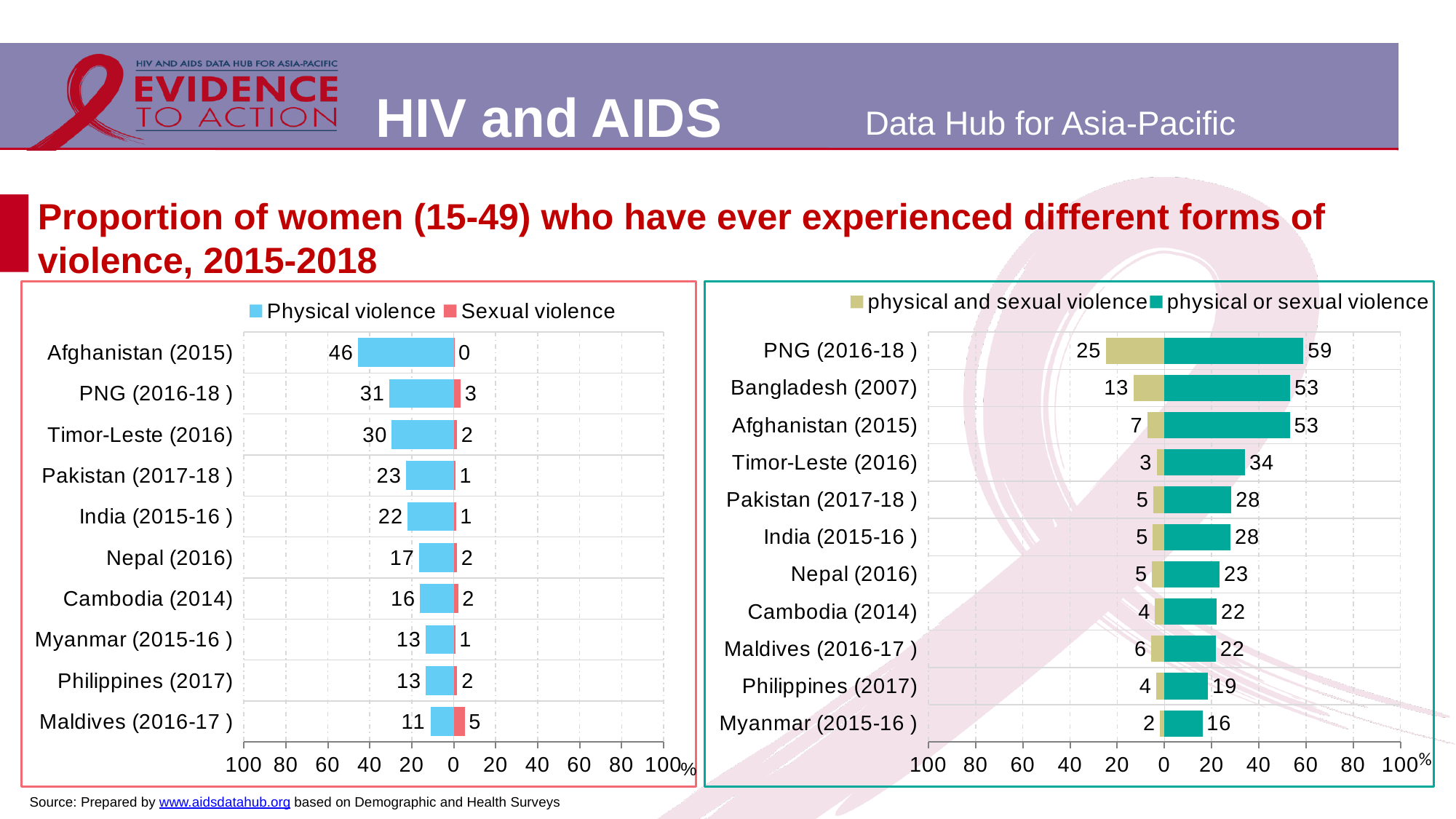
In the left chart (Physical violence / Sexual violence), what is the physical violence value for Afghanistan (2015)? 46 In the left chart (Physical violence / Sexual violence), how many series does the legend list? 2 In the right chart (physical and sexual violence / physical or sexual violence), how many countries are shown? 11 What kind of chart is the left chart (Physical violence / Sexual violence)? Bar chart In the left chart (Physical violence / Sexual violence), which country has the highest physical violence value? Afghanistan (2015) In the right chart (physical and sexual violence / physical or sexual violence), what is the physical and sexual violence value for Bangladesh (2007)? 13 In the right chart (physical and sexual violence / physical or sexual violence), which country has the lowest physical or sexual violence value? Myanmar (2015-16) In the right chart (physical and sexual violence / physical or sexual violence), what is the physical or sexual violence value for PNG (2016-18)? 59 In the left chart (Physical violence / Sexual violence), which country has the lowest physical violence value? Maldives (2016-17) In the left chart (Physical violence / Sexual violence), what is the difference between the physical violence values for PNG (2016-18) and Timor-Leste (2016)? 1 In the right chart (physical and sexual violence / physical or sexual violence), which is larger: the physical or sexual violence value for Timor-Leste (2016) or for Pakistan (2017-18)? Timor-Leste (2016) In the left chart (Physical violence / Sexual violence), what is the sexual violence value for Maldives (2016-17)? 5